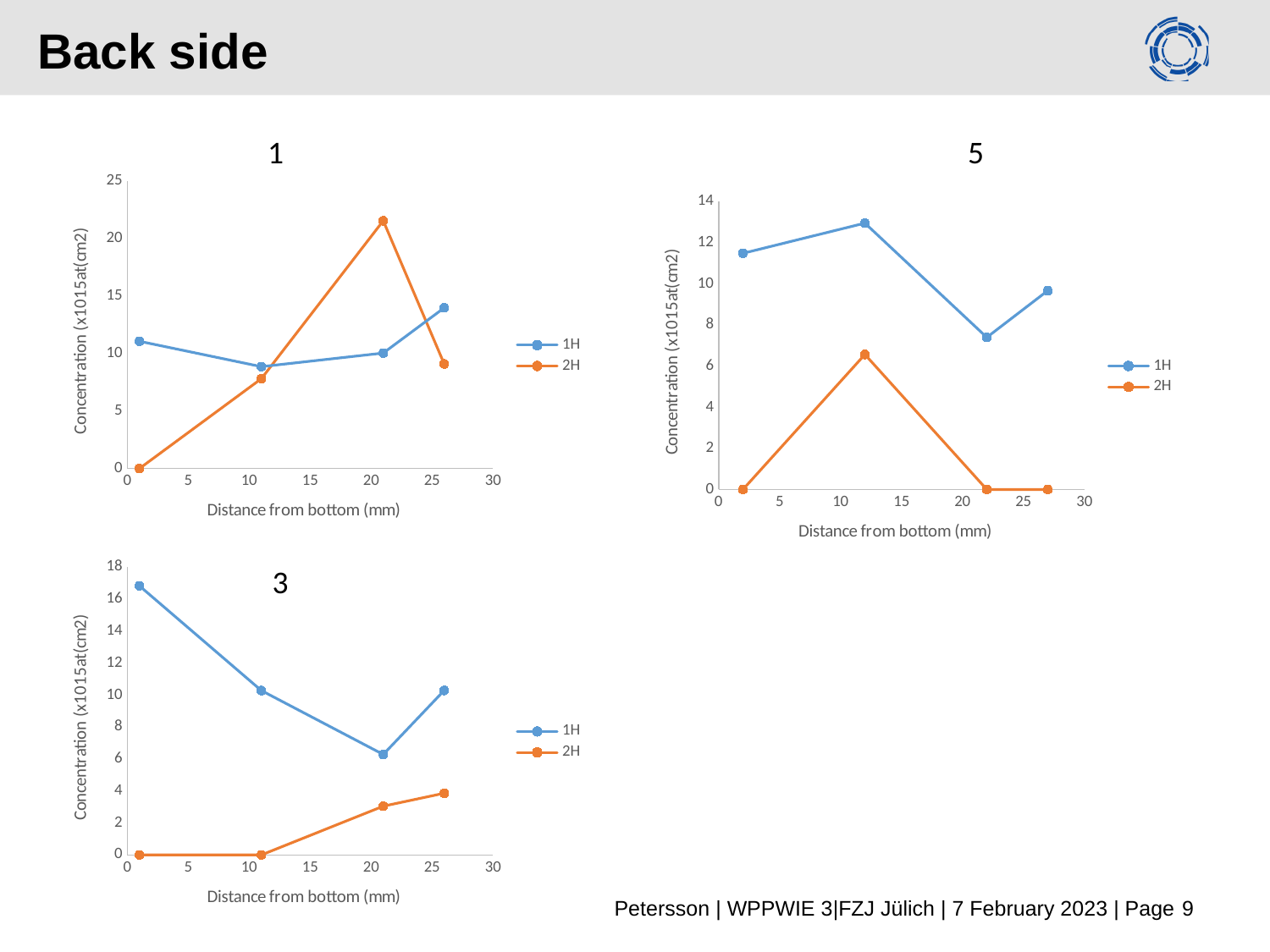
In the chart titled "1", which series reaches the highest concentration value? 2H In the chart titled "5", which series has the lower values at every distance? 2H What kind of chart is the chart titled "1"? line chart What is the x-axis label of the chart titled "3"? Distance from bottom (mm) In the chart titled "1", at the rightmost data point (about 26 mm), which series has the larger value, 1H or 2H? 1H In the chart titled "3", does the 2H series rise or fall as distance from bottom increases? rise In the chart titled "5", what is the 2H concentration at the last two data points (about 22 mm and 27 mm)? 0 In the chart titled "1", is the peak value of the 2H series greater or less than 20? greater In the chart titled "3", what is the 2H concentration at the first two data points? 0 In the chart titled "3", how many data points does the 1H series have? 4 How many series does the legend of the chart titled "5" list? 2 In the chart titled "5", is the highest 1H value greater or less than 12? greater